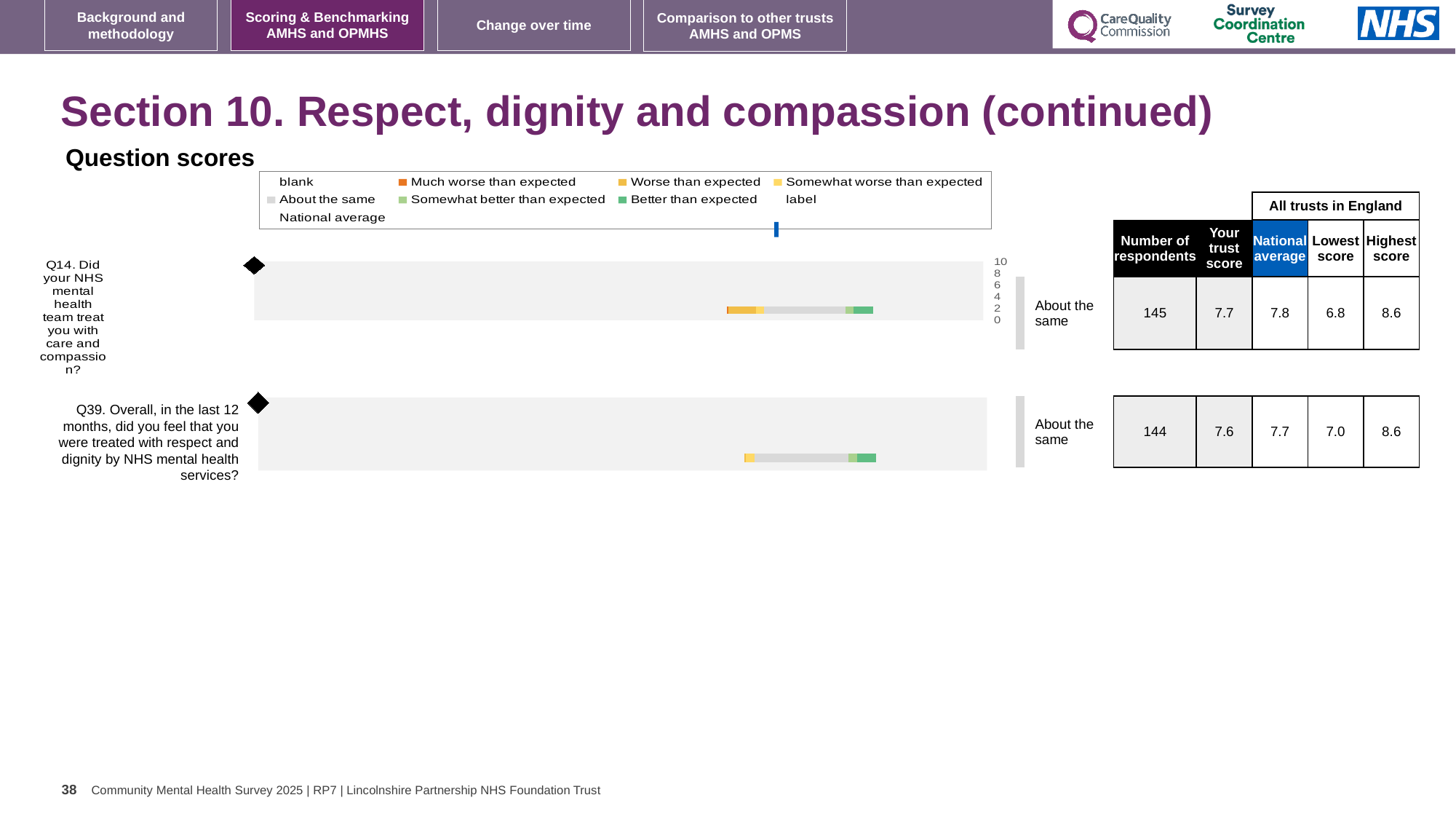
How many questions are plotted in the Question scores chart? 2 What is the lowest score among all trusts in England for Q39? 7.0 What kind of chart is used to show the question scores? bar chart How many respondents answered Q14? 145 Which legend entry is shown in orange? Much worse than expected What is the national average for Q39 (respect and dignity)? 7.7 Which question has the higher trust score, Q14 or Q39? Q14 What is the highest score among all trusts in England for Q14? 8.6 What is the difference between the national average and the trust score for Q14? 0.1 What is the difference between the highest and lowest scores for Q39? 1.6 What is the trust score for Q14 (care and compassion)? 7.7 What benchmark category is shown for Q39? About the same